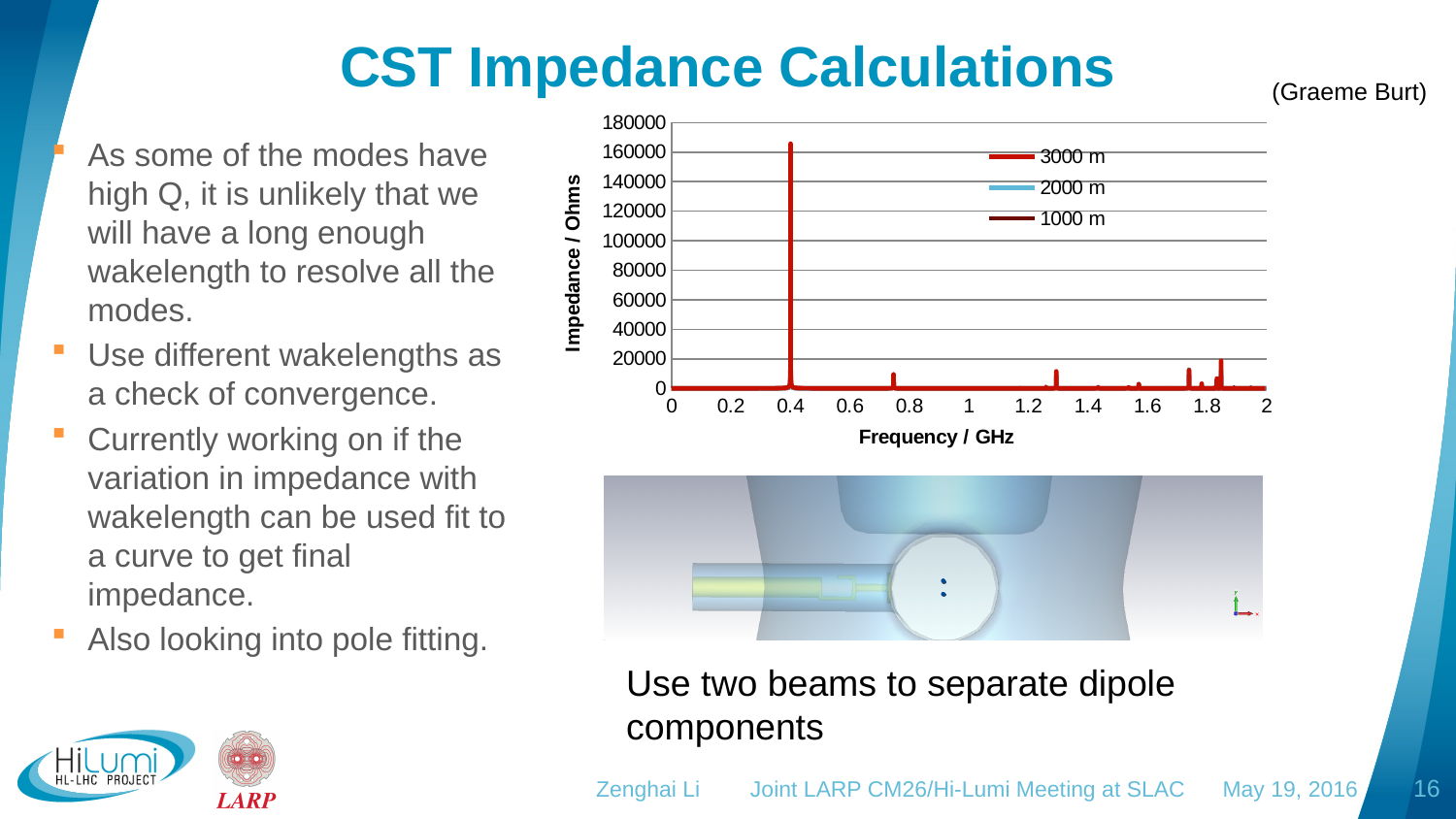
Which is larger: the impedance of the peak near 0.4 GHz or the peak near 1.3 GHz? the peak near 0.4 GHz Is the impedance of the peak near 1.3 GHz greater or less than 60000? less What are the three series listed in the chart legend? 3000 m, 2000 m, 1000 m How many series does the chart legend list? 3 Is the impedance of the tallest peak in the chart greater or less than 140000? greater What kind of chart is shown on the slide? line chart What is the label of the chart's y axis? Impedance / Ohms Is the impedance of the peak near 0.8 GHz greater or less than 40000? less